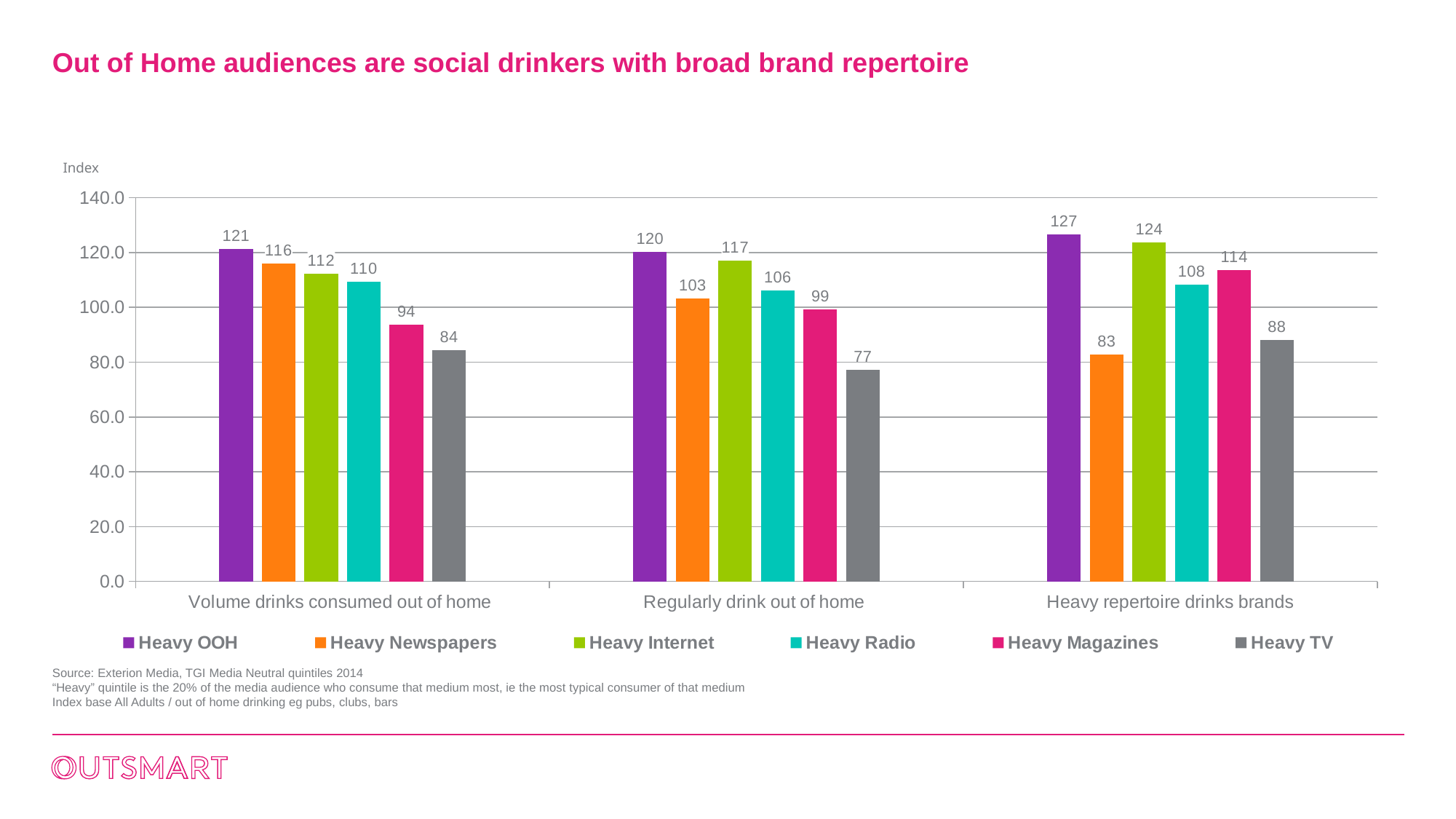
Which is larger for Regularly drink out of home: Heavy Internet or Heavy Radio? Heavy Internet What is the difference between the Heavy OOH and Heavy TV indices for Regularly drink out of home? 43 How many series does the legend list? 6 How many categories are shown on the x axis? 3 Which series has the lowest index for Volume drinks consumed out of home? Heavy TV What is the Heavy OOH index for Volume drinks consumed out of home? 121 Which series has the highest index for Heavy repertoire drinks brands? Heavy OOH Is the Heavy Magazines value for Volume drinks consumed out of home greater or less than 100? less What kind of chart is shown on the slide? bar chart What is the title of the slide? Out of Home audiences are social drinkers with broad brand repertoire What is the Heavy Newspapers index for Heavy repertoire drinks brands? 83 What is the Heavy TV index for Regularly drink out of home? 77